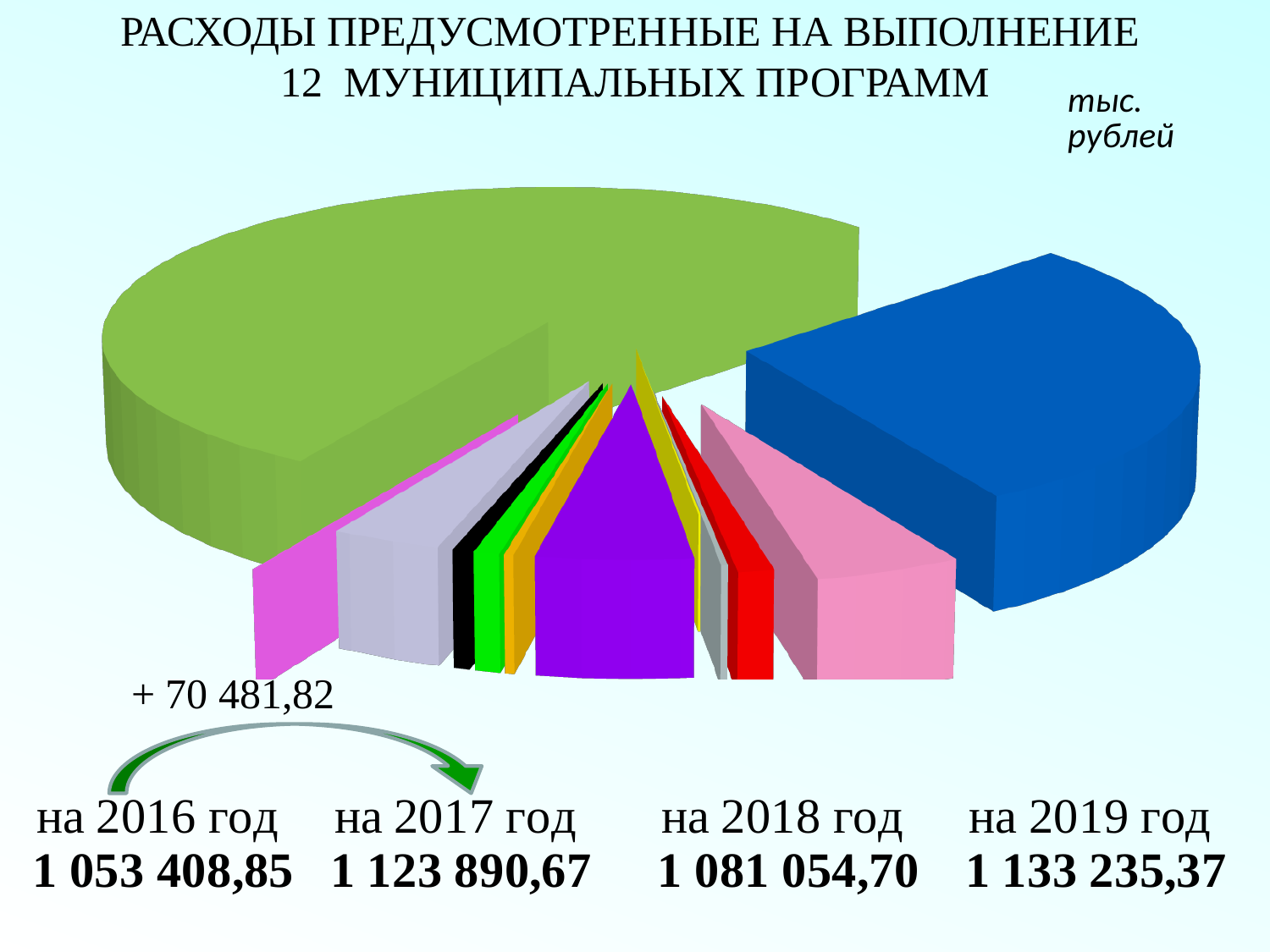
What is the expense amount shown for 2017? 1 123 890,67 Which colour slice of the pie chart is the largest? green In what units are the values on the slide given? тыс. рублей How many municipal programmes does the slide title say the expenses cover? 12 By how much does the 2017 amount exceed the 2016 amount, according to the slide? + 70 481,82 What is the expense amount shown for 2016? 1 053 408,85 Which is larger, the amount for 2017 or the amount for 2018? 2017 Which year has the lowest expense amount shown on the slide? 2016 Which year has the highest expense amount shown on the slide? 2019 What is the expense amount shown for 2019? 1 133 235,37 What is the expense amount shown for 2018? 1 081 054,70 What kind of chart is shown on the slide? pie chart